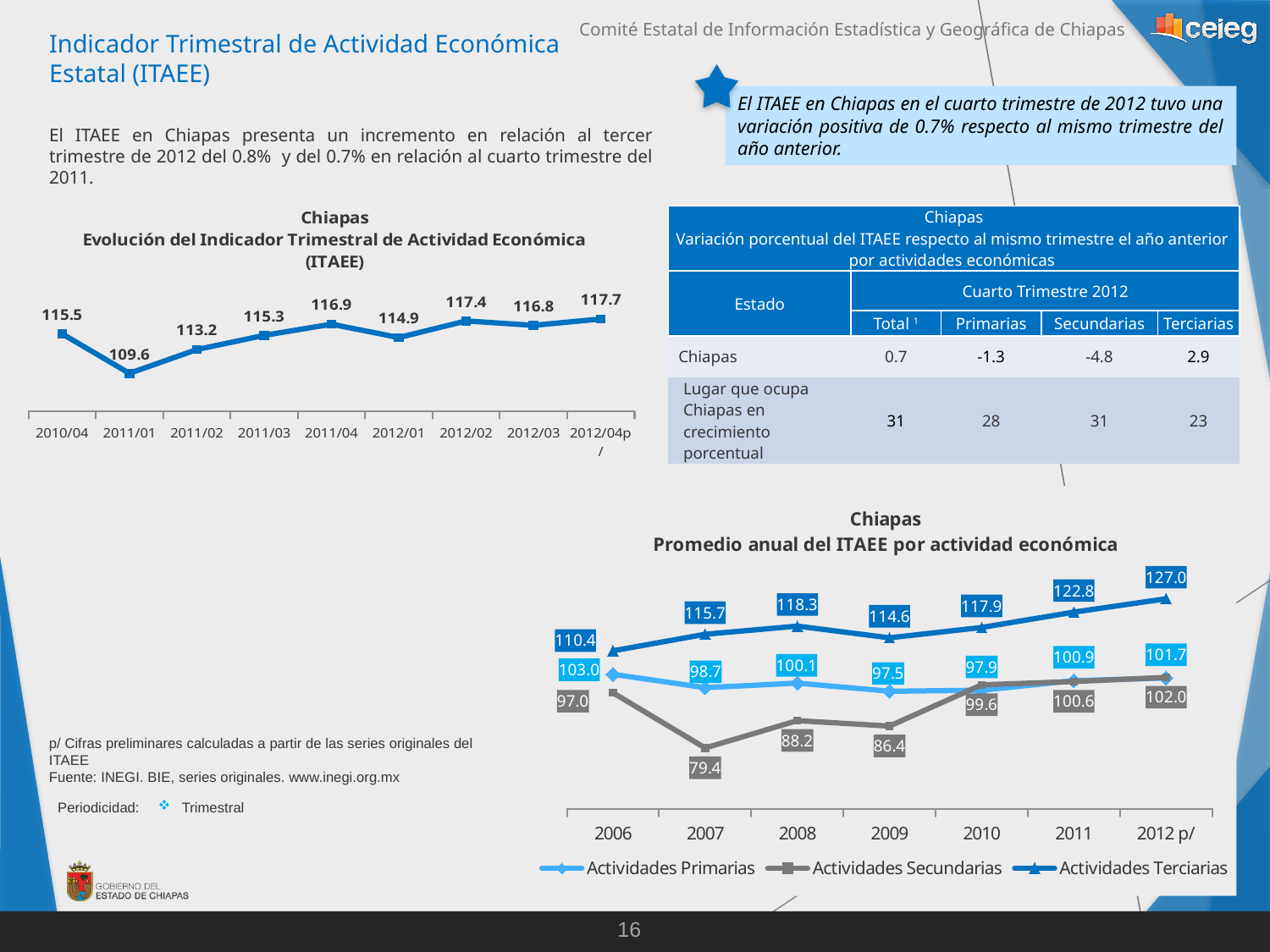
In the chart 'Evolución del Indicador Trimestral de Actividad Económica (ITAEE)', which quarter has the highest value? 2012/04p In the chart 'Promedio anual del ITAEE por actividad económica', which is larger in 2009: Actividades Primarias or Actividades Secundarias? Actividades Primarias In the chart 'Evolución del Indicador Trimestral de Actividad Económica (ITAEE)', how many quarters are plotted? 9 What kind of chart is 'Evolución del Indicador Trimestral de Actividad Económica (ITAEE)'? Line chart In the chart 'Promedio anual del ITAEE por actividad económica', in which year is Actividades Secundarias lowest? 2007 In the chart 'Evolución del Indicador Trimestral de Actividad Económica (ITAEE)', what is the difference between the values for 2012/04p and 2010/04? 2.2 In the chart 'Promedio anual del ITAEE por actividad económica', how many series does the legend list? 3 In the chart 'Evolución del Indicador Trimestral de Actividad Económica (ITAEE)', what is the value for 2011/01? 109.6 In the chart 'Promedio anual del ITAEE por actividad económica', what is the value for Actividades Terciarias in 2012 p/? 127.0 In the chart 'Evolución del Indicador Trimestral de Actividad Económica (ITAEE)', which quarter has the lowest value? 2011/01 In the chart 'Promedio anual del ITAEE por actividad económica', what is the difference between Actividades Terciarias and Actividades Primarias in 2011? 21.9 In the chart 'Promedio anual del ITAEE por actividad económica', what is the value for Actividades Secundarias in 2007? 79.4